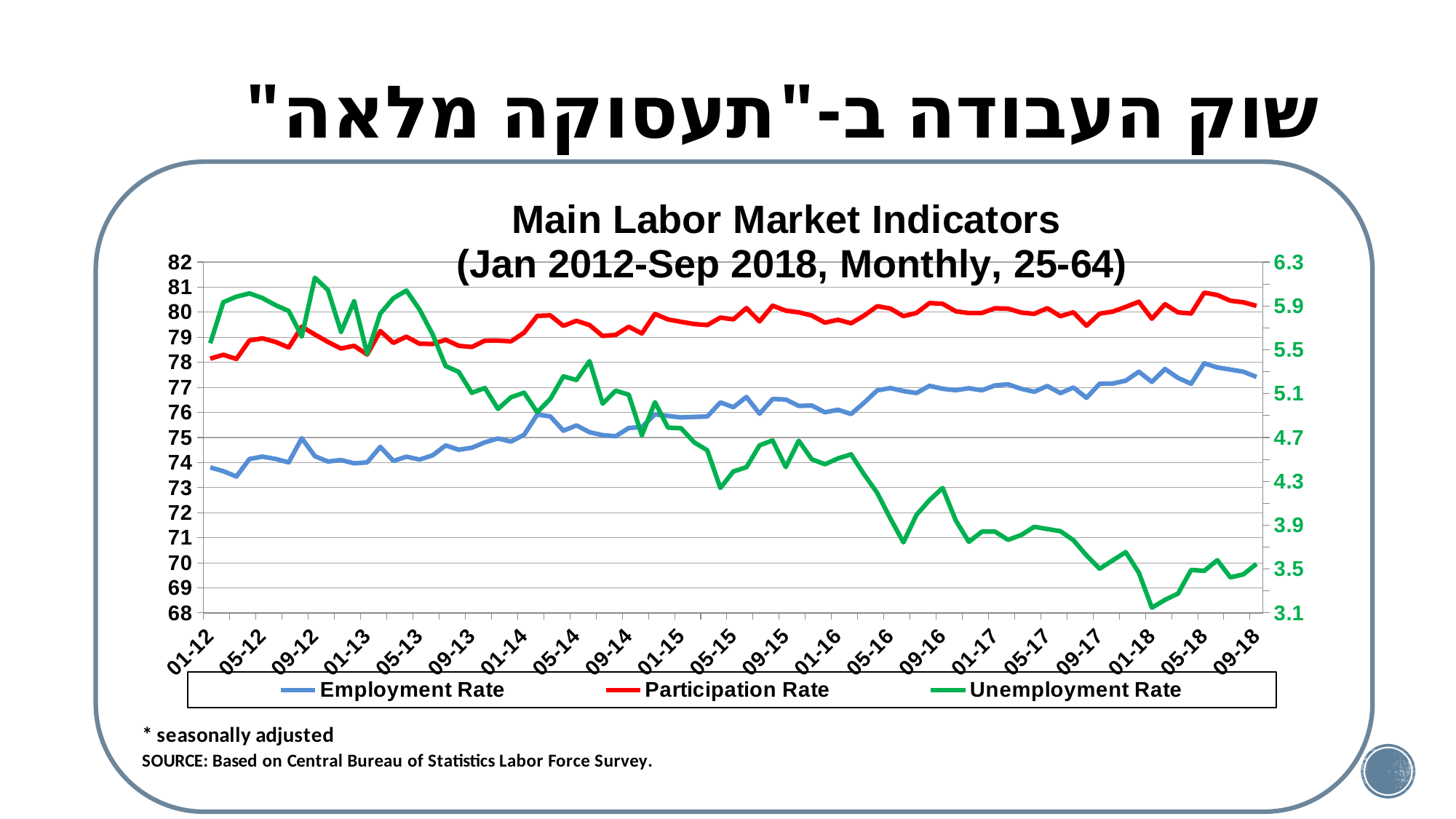
Does the Employment Rate rise or fall overall from 01-12 to 09-18? rise Does the Unemployment Rate rise or fall overall from 01-12 to 09-18? fall At 01-14, which is higher: the Participation Rate or the Employment Rate? Participation Rate How many series does the legend list? 3 Is the Unemployment Rate at 01-18 greater or less than 3.5? less Is the Participation Rate at 01-12 greater or less than 79? less Which series is plotted against the right-hand axis (3.1 to 6.3)? Unemployment Rate What kind of chart is shown on the slide? line chart Is the Employment Rate at 09-18 greater or less than 77? greater What is the title of the chart? Main Labor Market Indicators (Jan 2012-Sep 2018, Monthly, 25-64)